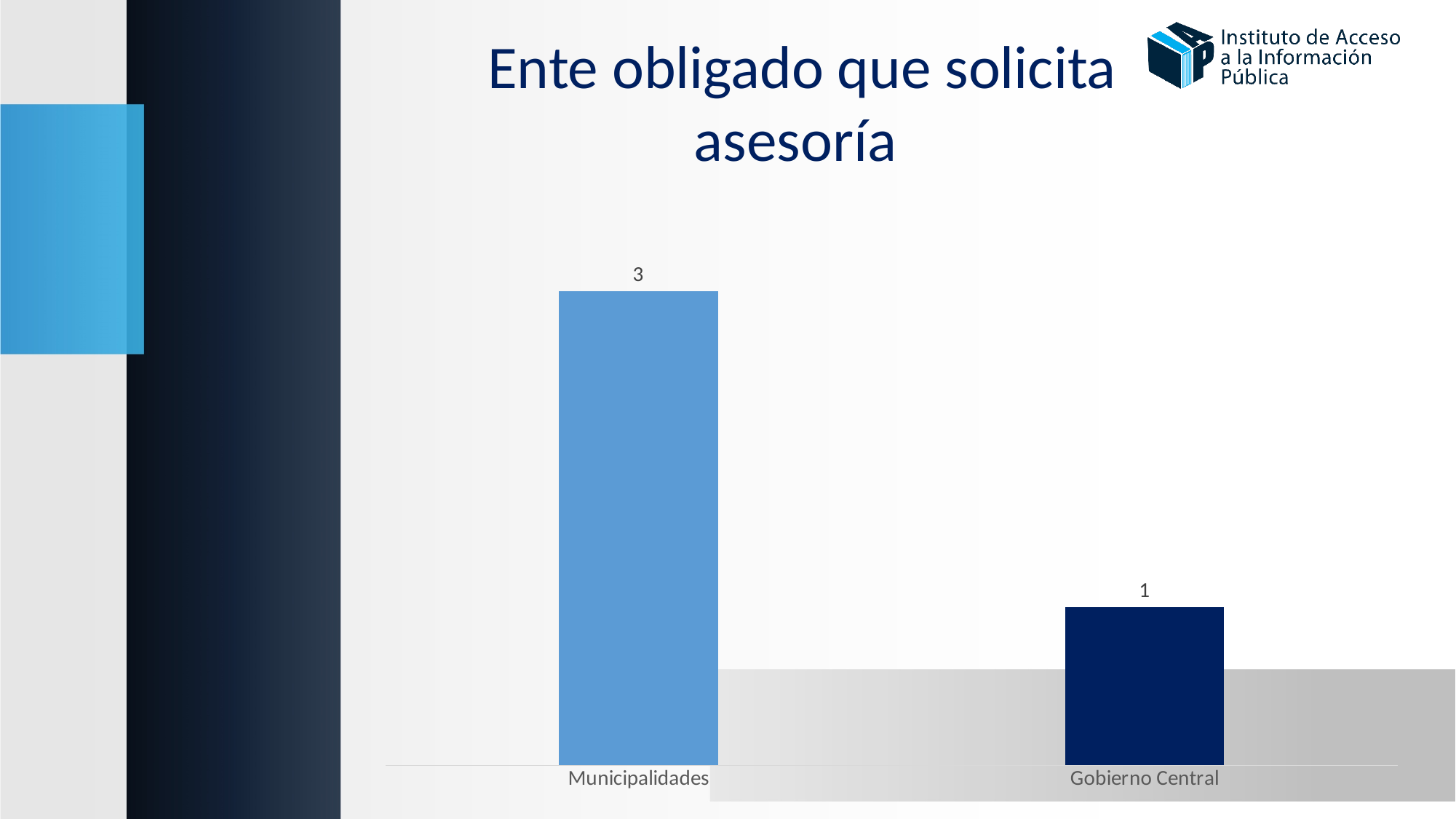
What is the difference between the values for Municipalidades and Gobierno Central? 2 What is the title of the slide containing the chart? Ente obligado que solicita asesoría What is the value for Gobierno Central? 1 Which is larger, the value for Municipalidades or the value for Gobierno Central? Municipalidades Which category has the highest value? Municipalidades How many categories are shown in the chart? 2 Which category has the lowest value? Gobierno Central What colour is the bar for Gobierno Central? Dark navy blue What is the value for Municipalidades? 3 What is the total of the values for Municipalidades and Gobierno Central? 4 What kind of chart is shown on the slide? Bar chart